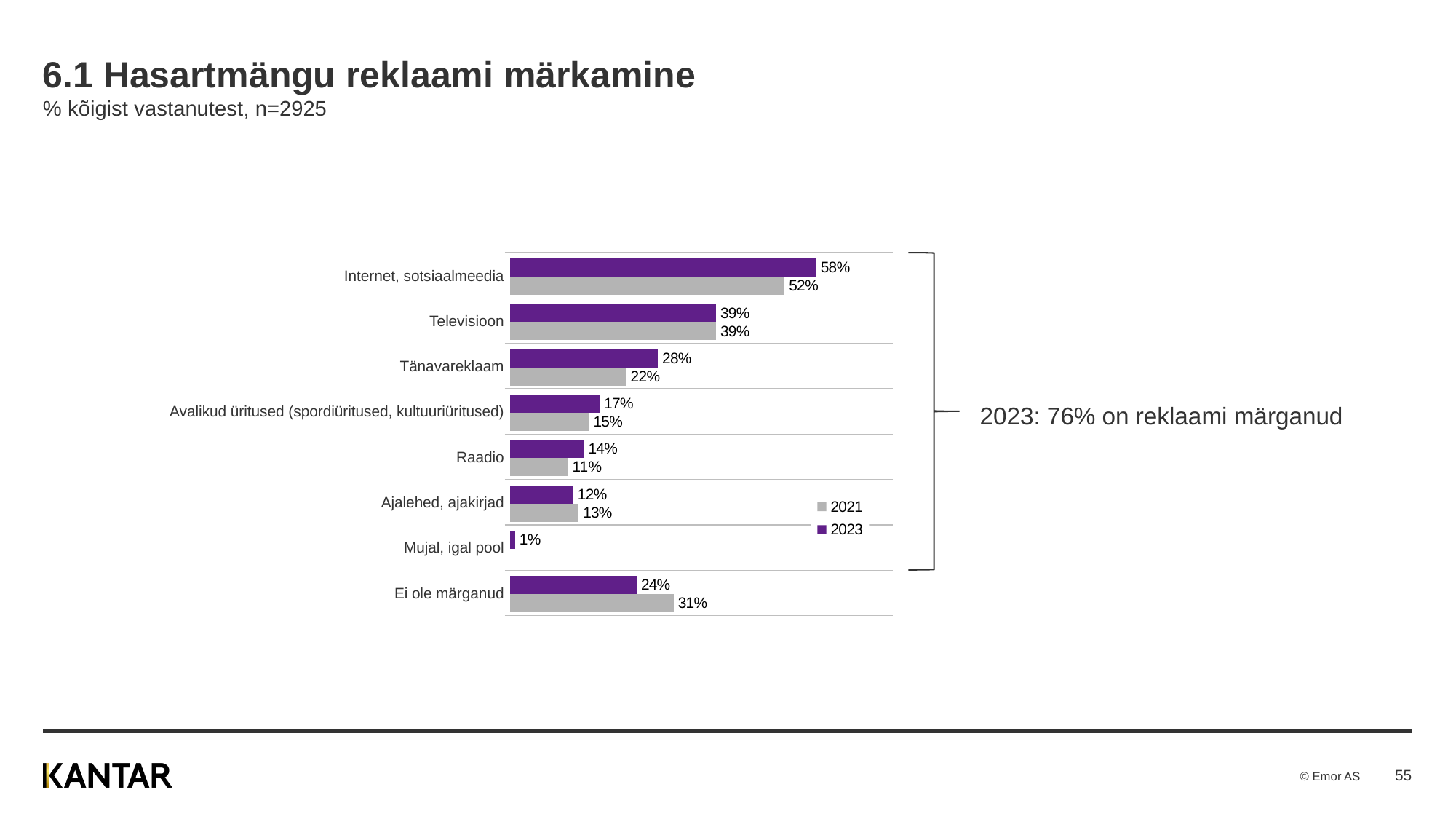
Which is larger for Raadio: the 2021 value or the 2023 value? 2023 What is the 2023 value for Internet, sotsiaalmeedia? 58% What is the difference between the 2021 and 2023 values for Ei ole märganud? 7% What kind of chart is shown on the slide? Bar chart What is the 2021 value for Tänavareklaam? 22% What is the difference between the 2023 and 2021 values for Internet, sotsiaalmeedia? 6% Which category has the highest 2023 value? Internet, sotsiaalmeedia Which is larger for Ajalehed, ajakirjad: the 2021 value or the 2023 value? 2021 What is the 2023 value for Ei ole märganud? 24% Which colour represents the 2023 series? Purple Which category has the lowest 2023 value? Mujal, igal pool How many series does the legend list? 2